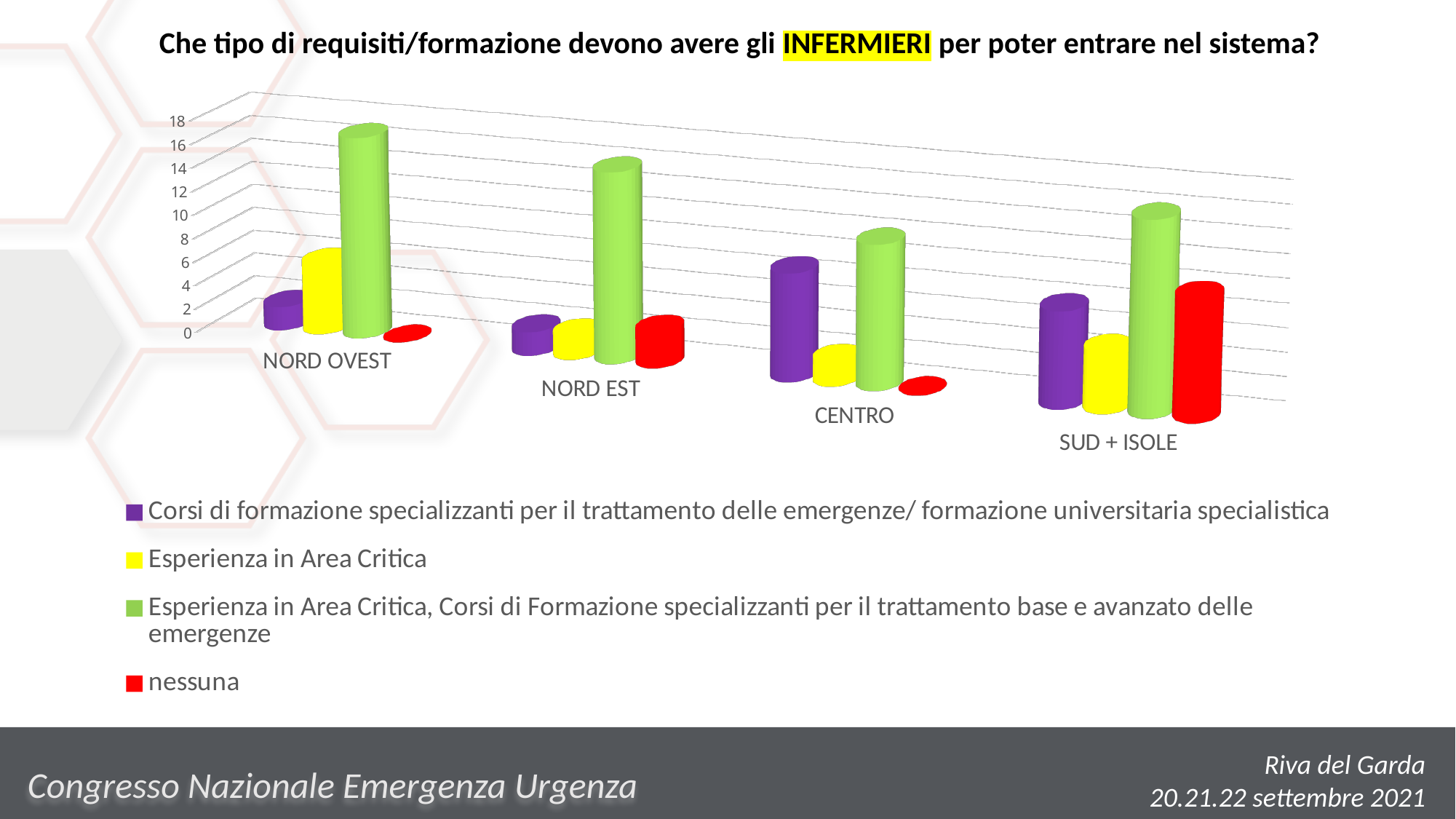
How many series does the legend list? 4 Which region has the larger value for 'nessuna': SUD + ISOLE or NORD OVEST? SUD + ISOLE Is the value of the green series for NORD EST greater or less than 8? greater What colour represents the 'nessuna' series in the legend? red What kind of chart is shown on the slide? bar chart Is the value of the green series (Esperienza in Area Critica, Corsi di Formazione specializzanti...) for NORD OVEST greater or less than 10? greater Which series has the highest value for NORD OVEST? Esperienza in Area Critica, Corsi di Formazione specializzanti per il trattamento base e avanzato delle emergenze Is the value of 'nessuna' for NORD OVEST greater or less than 2? less Which series has the lowest value for NORD OVEST? nessuna How many regional categories are shown on the x axis? 4